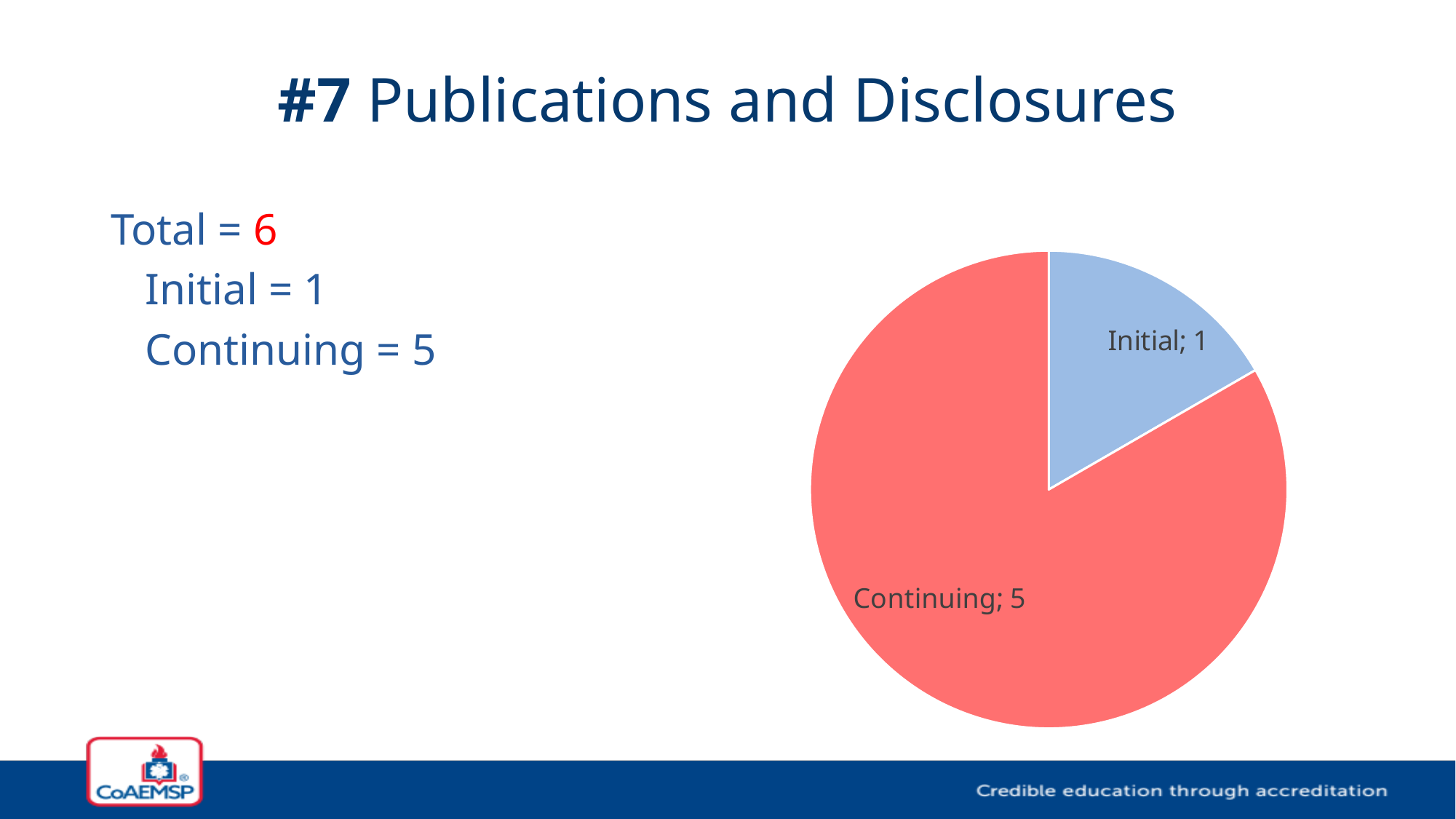
What share of the pie does the Initial slice represent? 1/6 What is the value for Continuing in the pie chart? 5 What is the value for Initial in the pie chart? 1 Which category has the smallest slice in the pie chart? Initial What is the total of all slices in the pie chart? 6 What is the title of the slide containing the pie chart? #7 Publications and Disclosures Which category has the largest slice in the pie chart? Continuing What colour is the Continuing slice? red What type of chart is shown on the slide? pie chart What is the difference between the Continuing and Initial values? 4 Which is larger, Initial or Continuing? Continuing How many slices does the pie chart have? 2